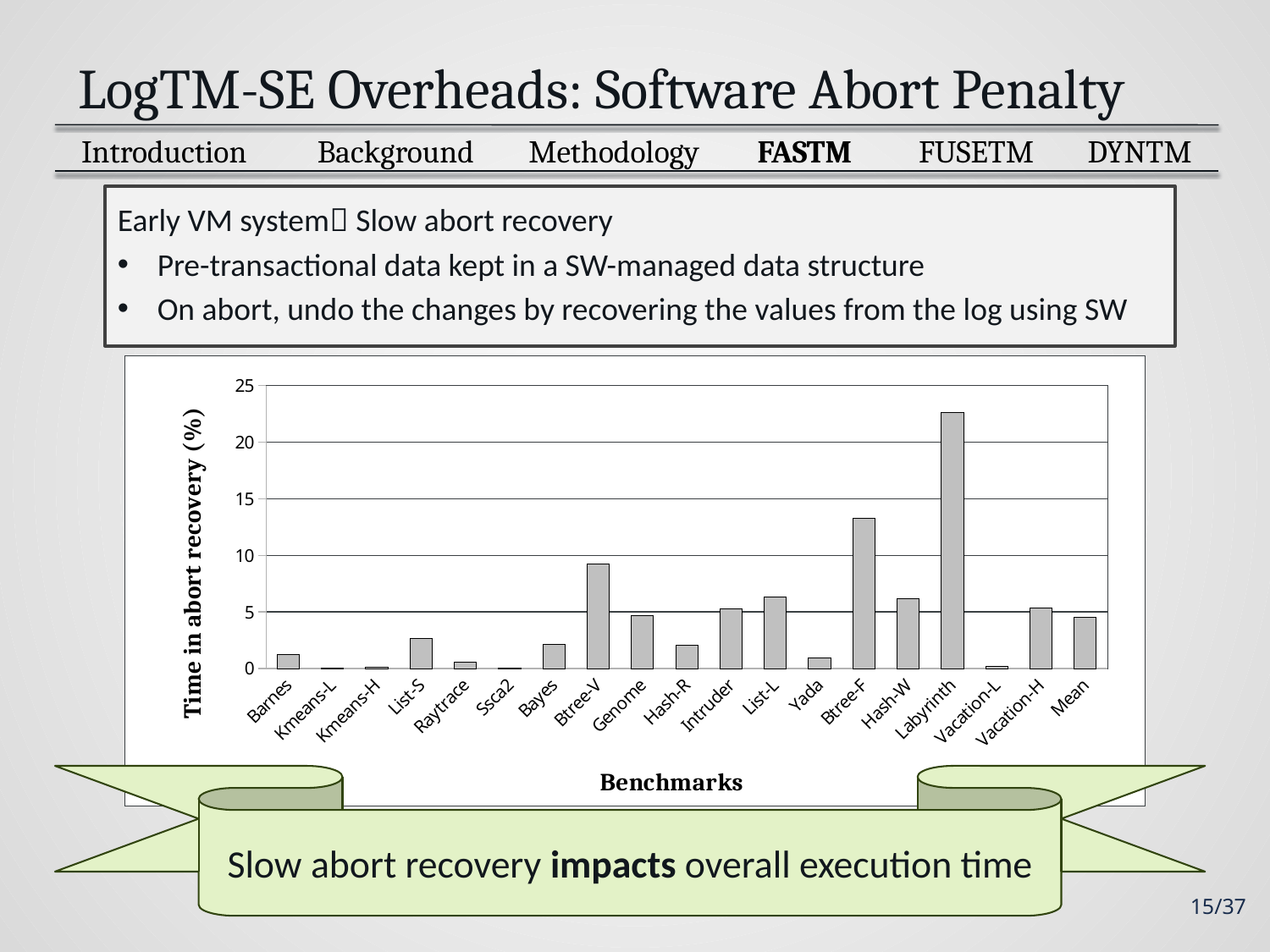
Is the value for Btree-F greater or less than 10? greater Which has a larger time in abort recovery, Btree-F or Btree-V? Btree-F How many benchmark categories are shown on the x axis of the chart? 19 What is the title of the x axis of the chart? Benchmarks What kind of chart is shown on the slide? bar chart What is the title of the y axis of the chart? Time in abort recovery (%) Is the value for Btree-V greater or less than 10? less Is the value for List-L greater or less than 5? greater Which benchmark has the highest time in abort recovery? Labyrinth Which has a larger time in abort recovery, Genome or Hash-R? Genome